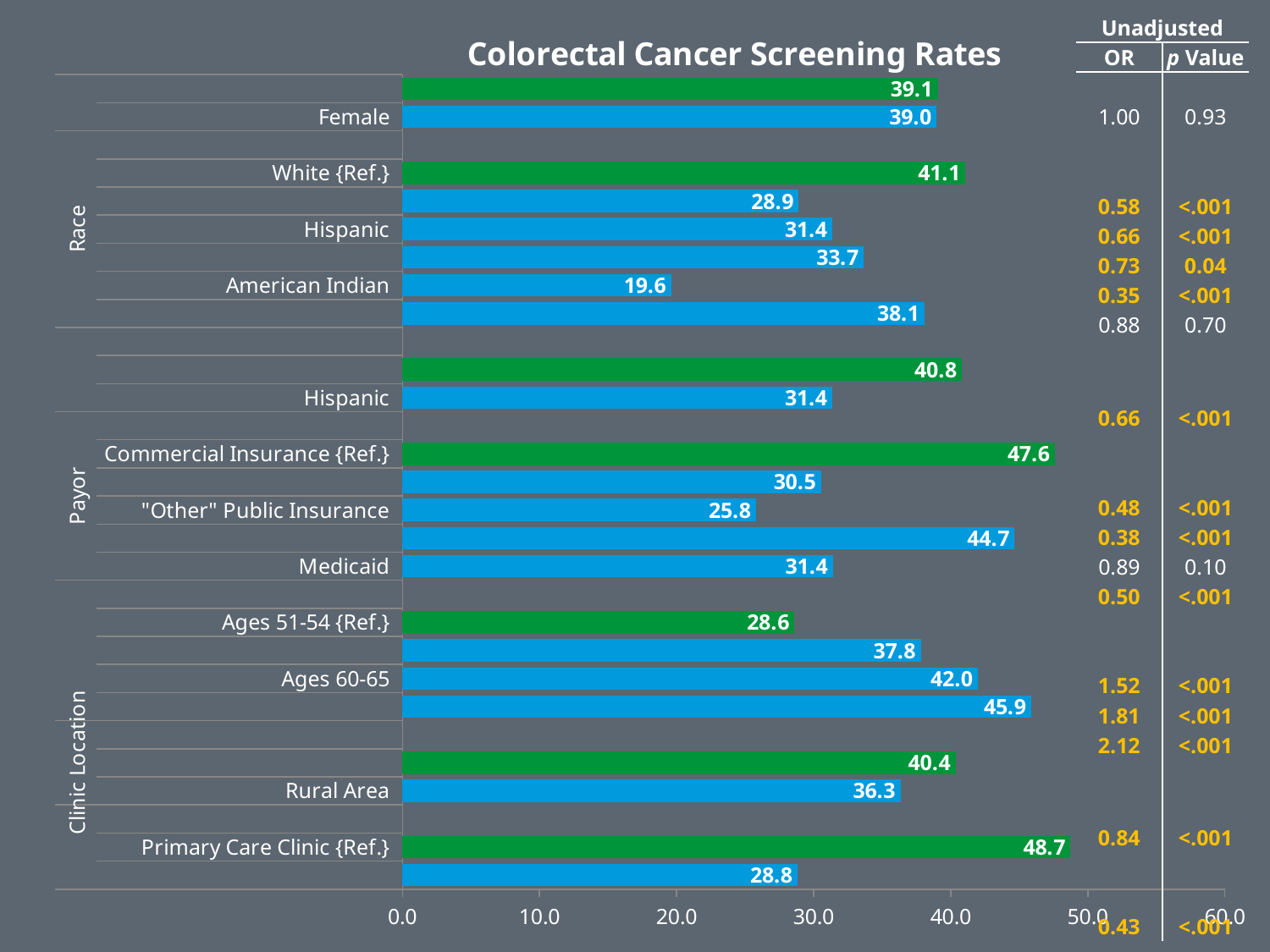
What is the colorectal cancer screening rate for Female? 39.0 What kind of chart is shown on the slide? Bar chart Which labeled category has the highest screening rate? Primary Care Clinic {Ref.} What is the difference between the screening rates for White {Ref.} and American Indian? 21.5 What is the screening rate for American Indian? 19.6 Which labeled category has the lowest screening rate? American Indian What is the difference between the screening rates for Ages 60-65 and Ages 51-54 {Ref.}? 13.4 What is the screening rate for Primary Care Clinic {Ref.}? 48.7 What is the screening rate for Commercial Insurance {Ref.}? 47.6 What is the title of the chart? Colorectal Cancer Screening Rates Is the screening rate for "Other" Public Insurance greater or less than 30.0? less Which has a higher screening rate, Medicaid or Rural Area? Rural Area